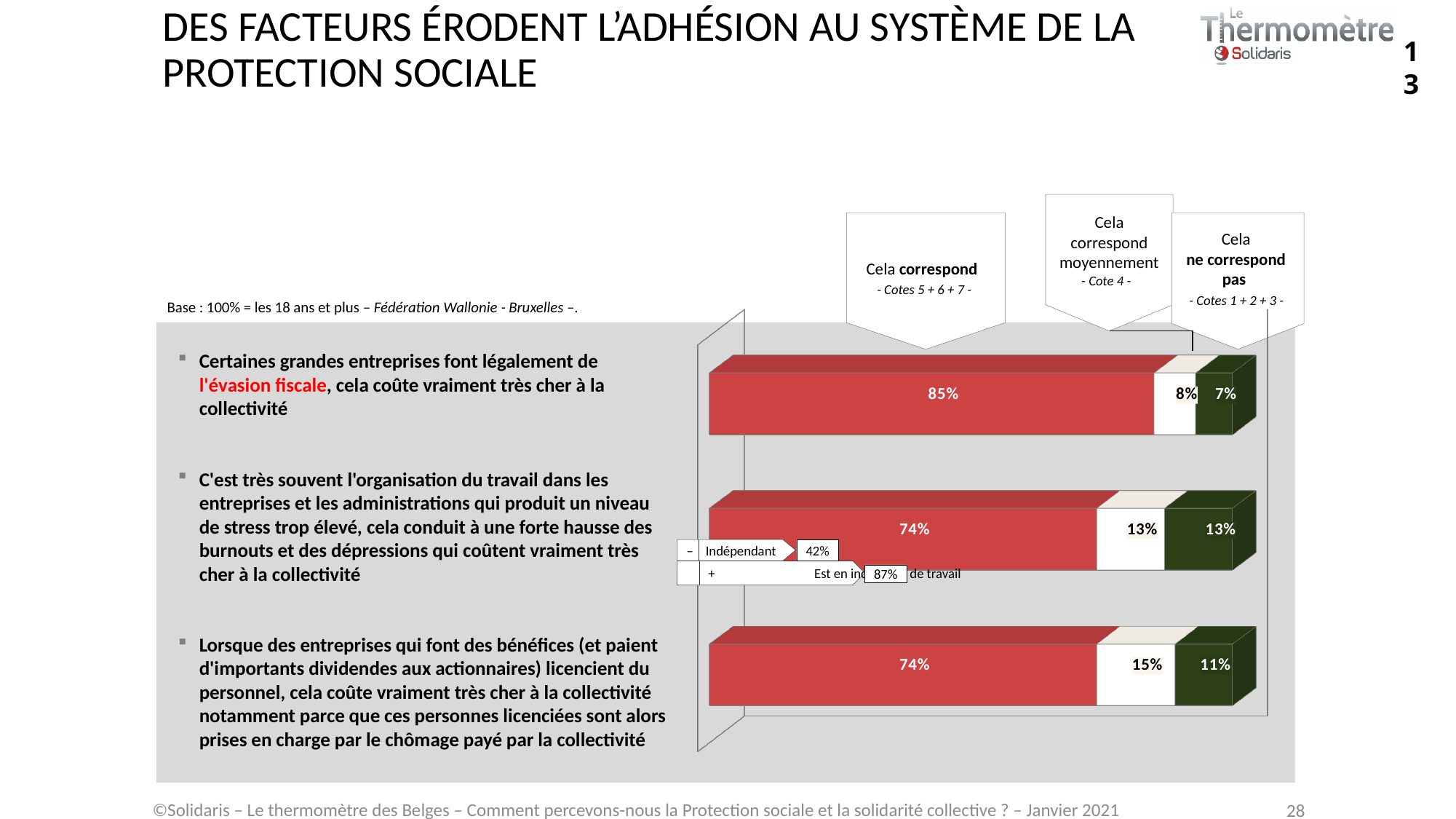
How many statements (bars) are shown in the chart? 3 What is the 'Cela correspond moyennement' value for the statement about profitable companies laying off staff? 15% Which response category is shown in red? Cela correspond What is the 'Cela ne correspond pas' value for the statement about profitable companies laying off staff? 11% What type of chart is used on this slide? Stacked bar chart What is the 'Cela ne correspond pas' value for the statement about work organisation causing stress, burnouts and depressions? 13% Which statement has the lowest 'Cela ne correspond pas' share? Certaines grandes entreprises font légalement de l'évasion fiscale Which statement has the highest 'Cela correspond' share? Certaines grandes entreprises font légalement de l'évasion fiscale What percentage of respondents say 'Cela correspond' for the statement about large companies legally practising tax evasion (l'évasion fiscale)? 85% What is the difference between the 'Cela correspond' share for the tax evasion statement and the 'Cela correspond' share for the burnout statement? 11% Is the 'Cela correspond moyennement' value larger for the burnout statement or for the layoffs statement? The layoffs statement How many response categories are shown for each bar? 3